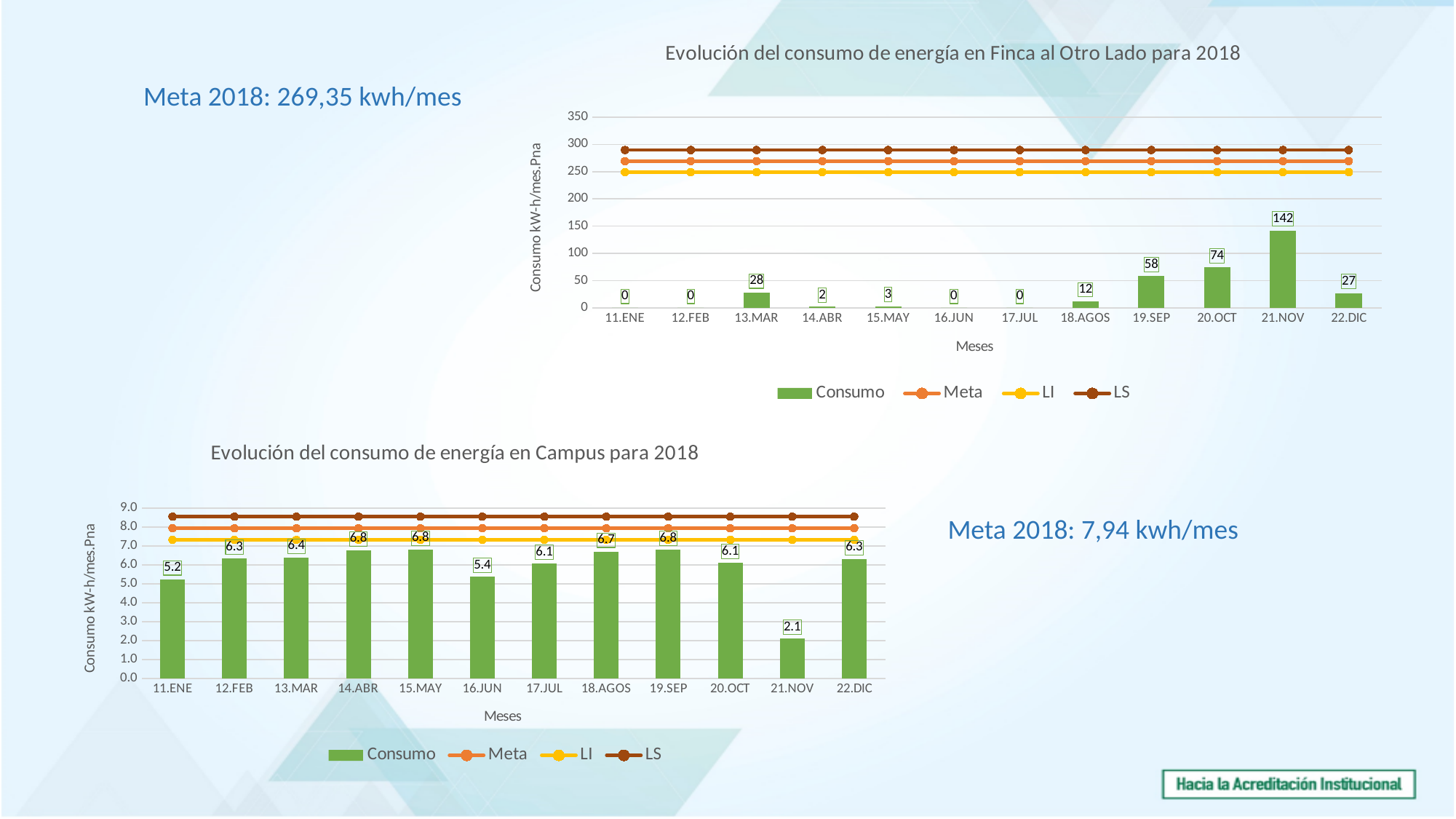
What colour are the Consumo bars in the chart 'Evolución del consumo de energía en Campus para 2018'? Green In the chart 'Evolución del consumo de energía en Finca al Otro Lado para 2018', what is the difference between the Consumo values for 20.OCT and 19.SEP? 16 In the chart 'Evolución del consumo de energía en Campus para 2018', what is the difference between the Consumo values for 14.ABR and 16.JUN? 1.4 In the chart 'Evolución del consumo de energía en Campus para 2018', which is larger, the Consumo value for 11.ENE or for 12.FEB? 12.FEB In the chart 'Evolución del consumo de energía en Finca al Otro Lado para 2018', what is the Consumo value for 13.MAR? 28 In the chart 'Evolución del consumo de energía en Finca al Otro Lado para 2018', what is the Consumo value for 21.NOV? 142 In the chart 'Evolución del consumo de energía en Finca al Otro Lado para 2018', how many series does the legend list? 4 In the chart 'Evolución del consumo de energía en Finca al Otro Lado para 2018', is the LS line greater or less than 250? greater In the chart 'Evolución del consumo de energía en Campus para 2018', how many months are shown on the x axis? 12 In the chart 'Evolución del consumo de energía en Campus para 2018', which month has the lowest Consumo value? 21.NOV In the chart 'Evolución del consumo de energía en Finca al Otro Lado para 2018', which month has the highest Consumo value? 21.NOV In the chart 'Evolución del consumo de energía en Campus para 2018', what is the Consumo value for 21.NOV? 2.1